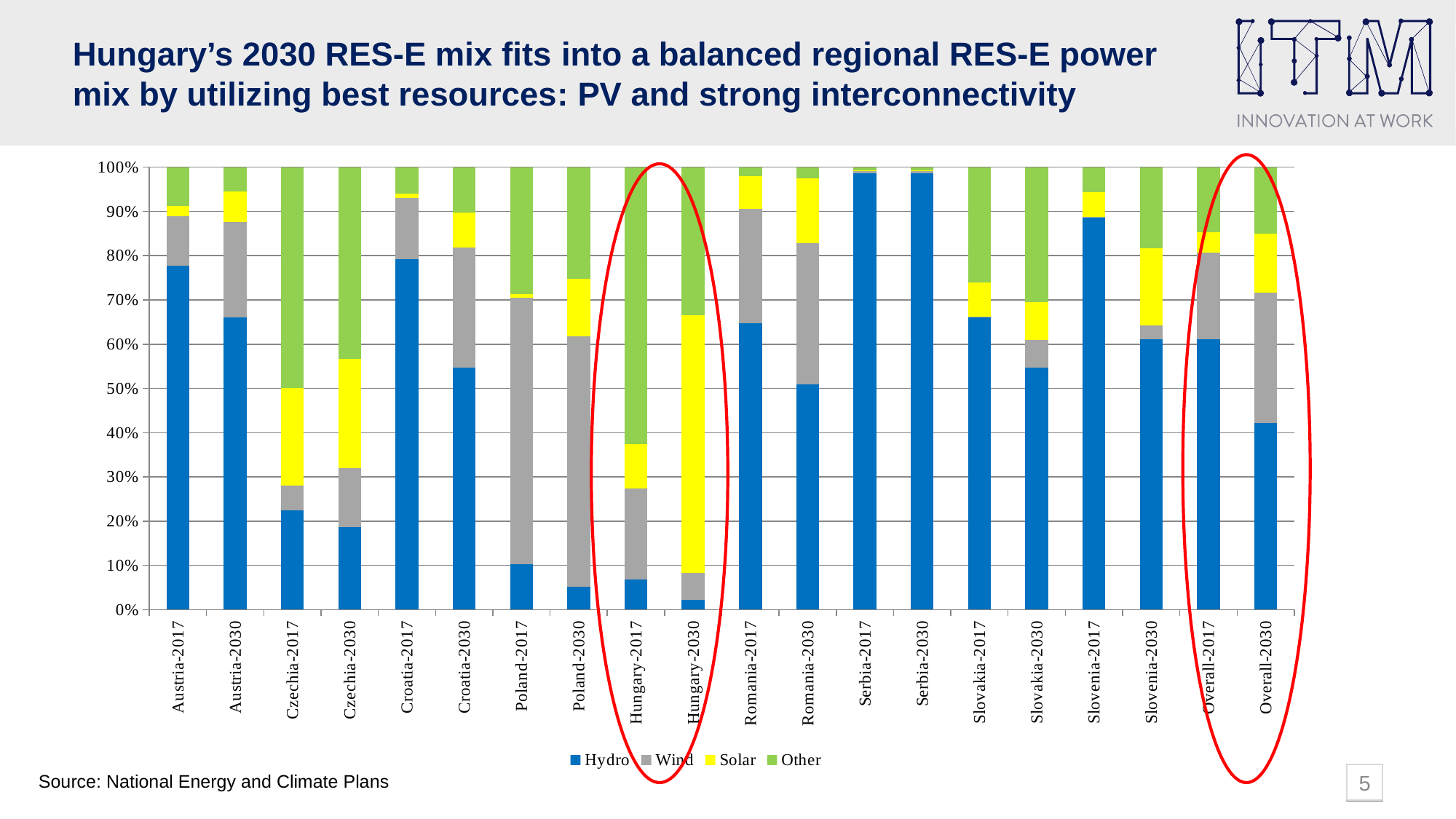
Is the Hydro share for Serbia-2017 greater or less than 90%? greater Which category has the largest Solar share? Hungary-2030 Is the Hydro share for Overall-2030 greater or less than 50%? less Which category has the lowest Hydro share? Hungary-2030 Which colour represents Solar in the legend? yellow How many series does the legend list? 4 Does the Hydro share for Hungary rise or fall from 2017 to 2030? fall Is the Hydro share for Austria-2017 greater or less than 70%? greater How many country-year categories are shown on the x axis? 20 Which has the larger Hydro share, Austria-2017 or Austria-2030? Austria-2017 What kind of chart is shown on the slide? stacked bar chart